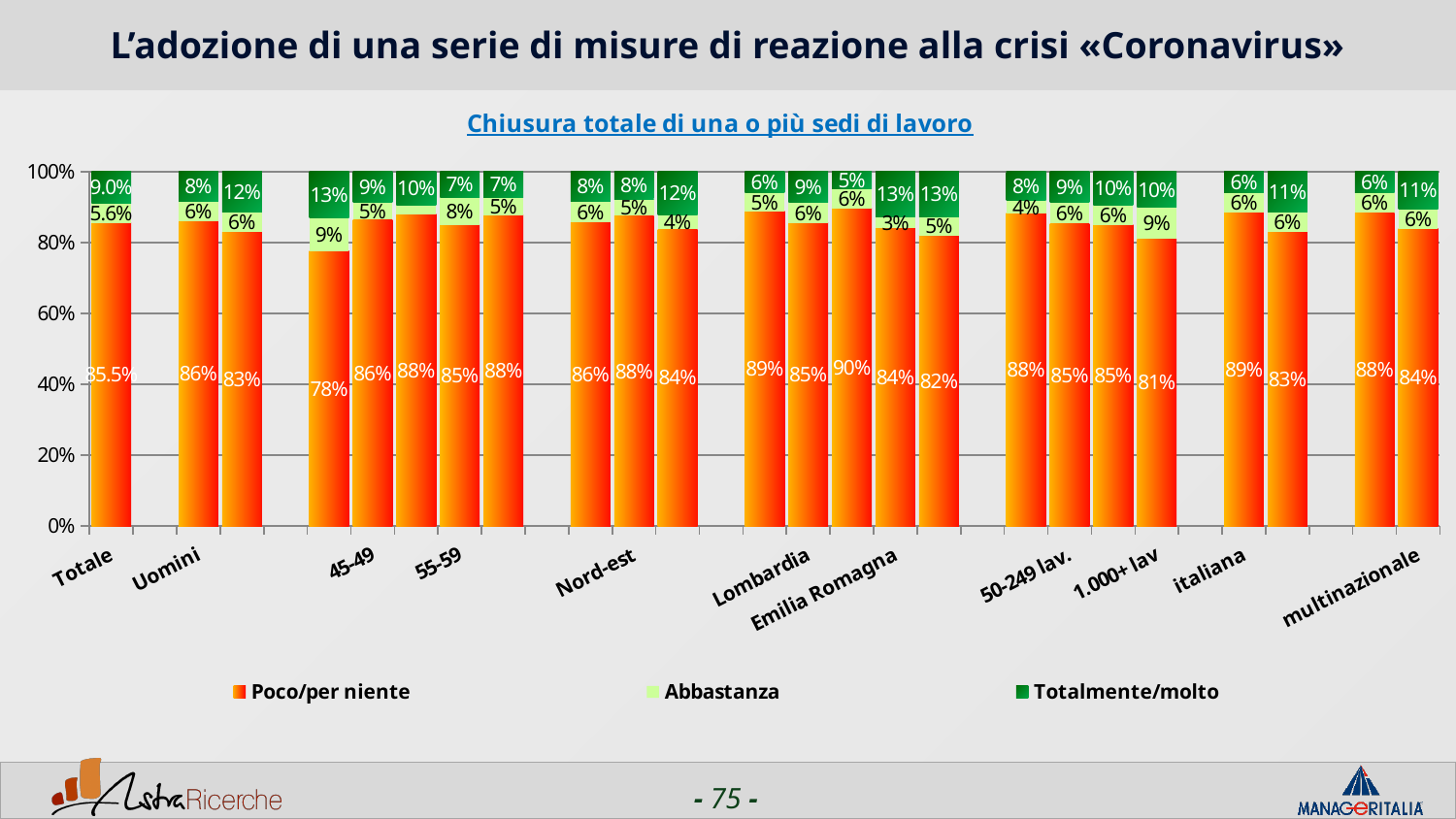
What is the difference between the 'Totalmente/molto' and 'Abbastanza' values for Totale? 3.4 percentage points What is the 'Poco/per niente' value for Totale? 85.5% Is the 'Poco/per niente' value for Uomini greater or less than 80%? greater What is the 'Poco/per niente' value for Uomini? 86% What is the 'Totalmente/molto' value for Uomini? 8% What kind of chart is shown on the slide? Stacked bar chart What is the 'Totalmente/molto' value for Totale? 9.0% What is the 'Poco/per niente' value for 1.000+ lav? 81% How many series does the legend list? 3 Which is larger, the 'Poco/per niente' value for Totale or for Uomini? Uomini What is the 'Abbastanza' value for Totale? 5.6% What is the subtitle shown above the chart? Chiusura totale di una o più sedi di lavoro